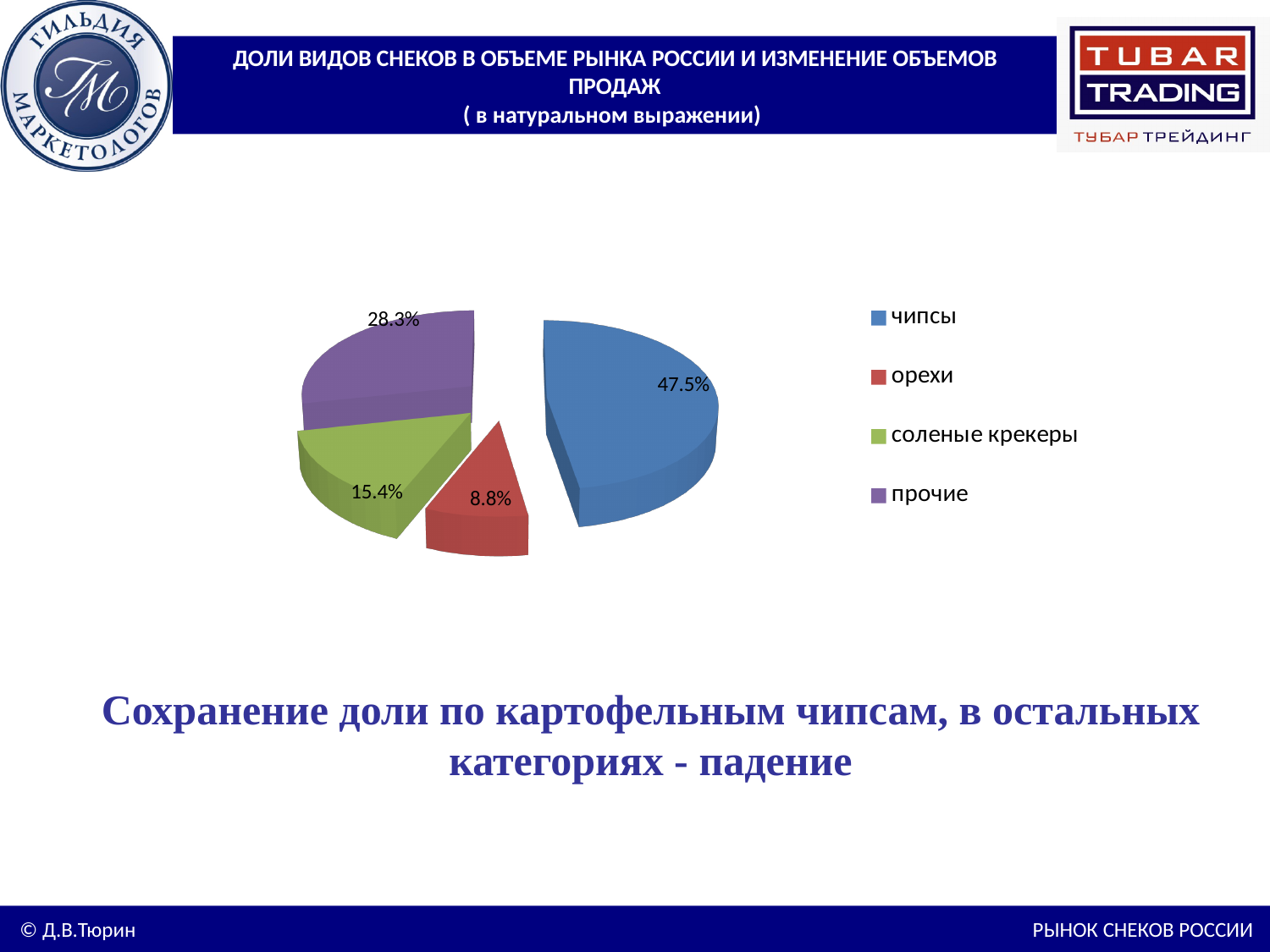
What is the share for соленые крекеры? 15.4% Which category has the smallest share of the pie? орехи What is the difference in percentage points between the share for чипсы and the share for прочие? 19.2 What is the difference in percentage points between the share for соленые крекеры and the share for орехи? 6.6 Which category has the largest share of the pie? чипсы What is the share for прочие? 28.3% What is the share for орехи? 8.8% What is the share for чипсы? 47.5% What kind of chart is shown on the slide? pie chart How many categories does the pie chart show? 4 What colour is the slice for орехи? red Which is larger, the share for прочие or the share for соленые крекеры? прочие